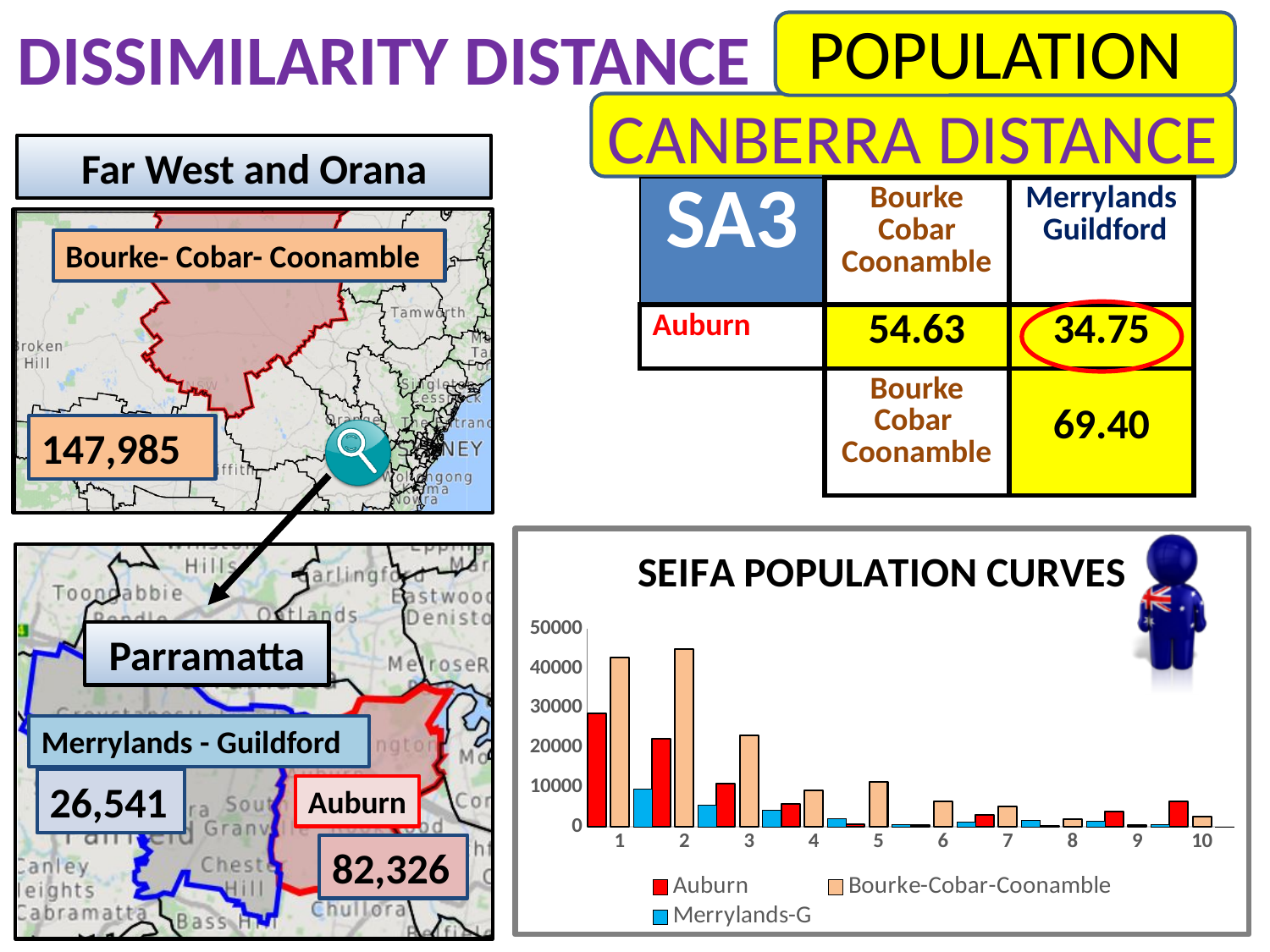
In the SEIFA POPULATION CURVES chart, is the Bourke-Cobar-Coonamble value for category 2 greater or less than 40000? greater In the SEIFA POPULATION CURVES chart, which category has the highest Auburn value? 1 How many categories are shown on the x axis of the SEIFA POPULATION CURVES chart? 10 What kind of chart is the SEIFA POPULATION CURVES chart? bar chart In the SEIFA POPULATION CURVES chart, for category 1, which is larger: the Auburn value or the Bourke-Cobar-Coonamble value? Bourke-Cobar-Coonamble In the SEIFA POPULATION CURVES chart, is the Merrylands-G value for category 1 greater or less than 5000? greater What colour are the Auburn bars in the SEIFA POPULATION CURVES chart? red In the SEIFA POPULATION CURVES chart, is the Auburn value for category 3 greater or less than 20000? less How many series does the legend of the SEIFA POPULATION CURVES chart list? 3 In the SEIFA POPULATION CURVES chart, do the Bourke-Cobar-Coonamble values generally rise or fall from category 2 to category 9? fall